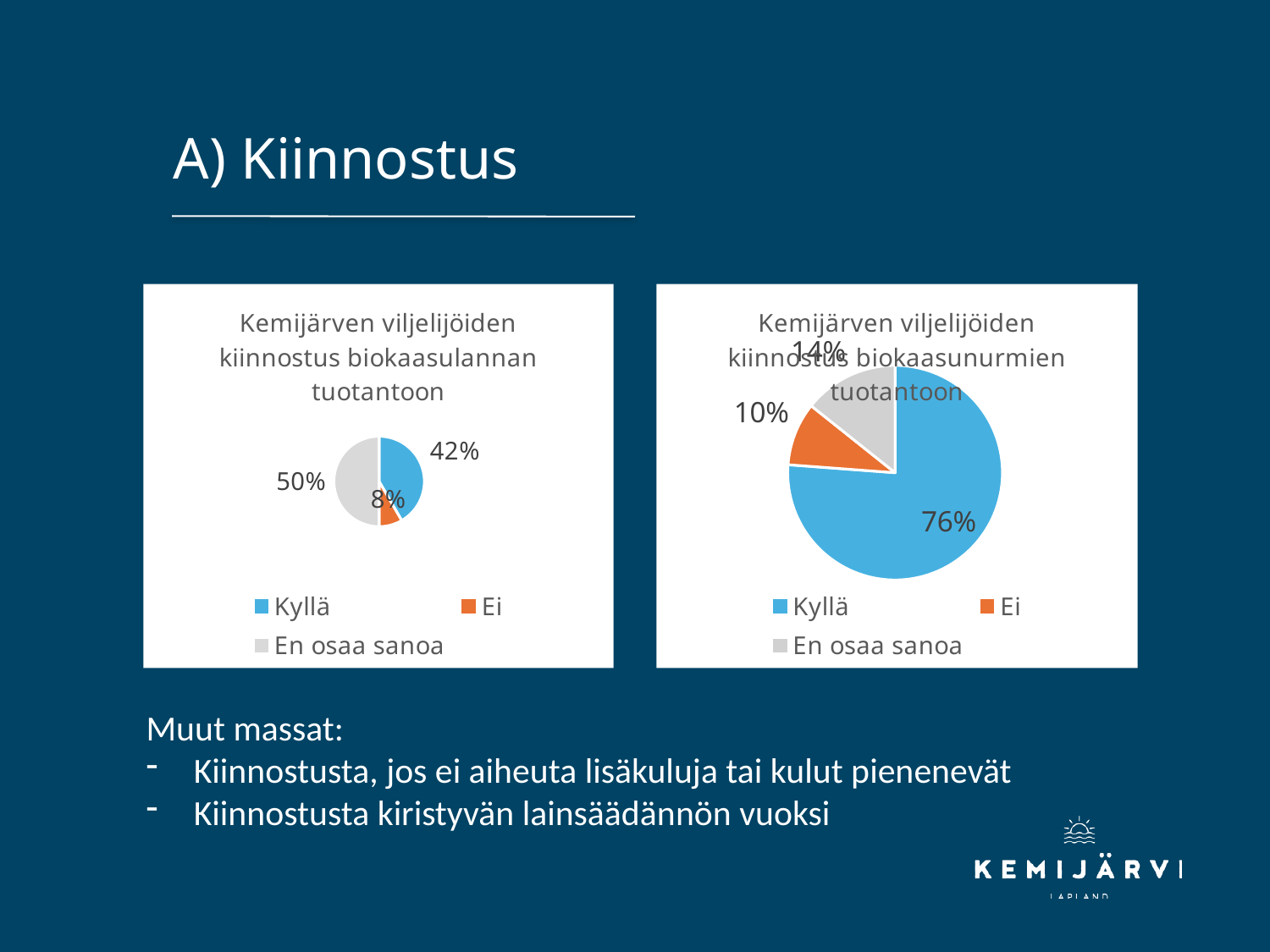
Which chart has the larger Kyllä share, the left chart or the right chart? The right chart In the right chart (biokaasunurmien tuotantoon), what is the difference in percentage points between Kyllä and En osaa sanoa? 62 How many entries does the legend of the right chart list? 3 In the left chart (biokaasulannan tuotantoon), what share of respondents answered En osaa sanoa? 50% In the right chart (biokaasunurmien tuotantoon), which answer has the largest slice? Kyllä What type of chart is used on the left side of the slide? Pie chart In the left chart, what colour represents the En osaa sanoa slice? Grey In the left chart (biokaasulannan tuotantoon), what share of respondents answered Ei? 8% In the right chart (biokaasunurmien tuotantoon), what share of respondents answered Kyllä? 76% In the left chart (biokaasulannan tuotantoon), what share of respondents answered Kyllä? 42% In the left chart (biokaasulannan tuotantoon), which answer has the smallest slice? Ei In the right chart (biokaasunurmien tuotantoon), what share of respondents answered Ei? 10%